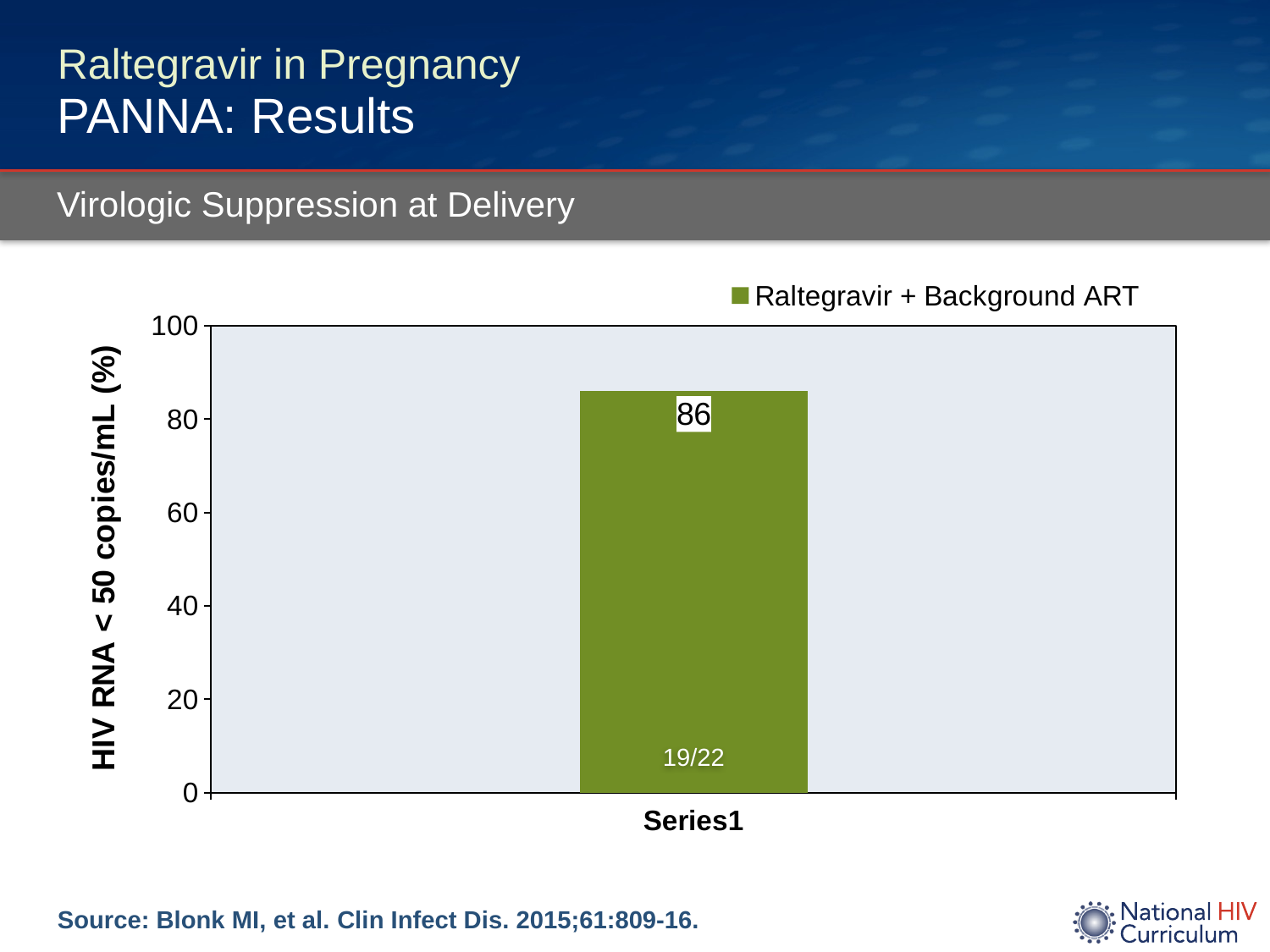
What is the maximum value shown on the y axis? 100 Is the value for Raltegravir + Background ART greater or less than 100? less How many bars are plotted in the chart? 1 Is the value for Raltegravir + Background ART greater or less than 80? greater What kind of chart is shown on the slide? Bar chart What fraction is printed at the bottom of the bar? 19/22 What is the value shown on the bar for Raltegravir + Background ART? 86 How many series does the legend list? 1 What series name appears in the legend? Raltegravir + Background ART What is the label on the y axis? HIV RNA < 50 copies/mL (%)